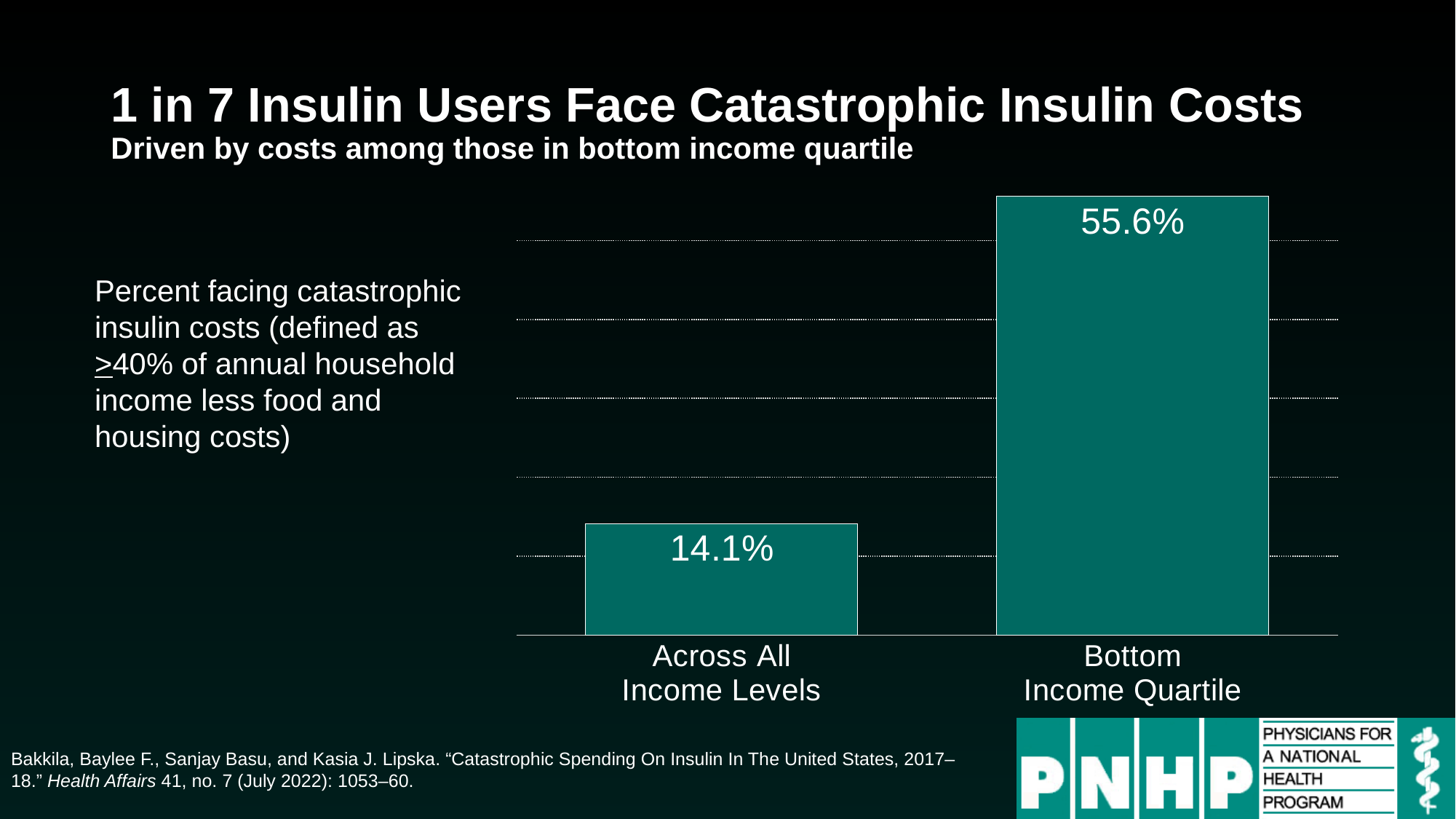
Is the value for the bottom income quartile larger or smaller than the value across all income levels? larger What percent of insulin users across all income levels face catastrophic insulin costs? 14.1% What is the difference in percentage points between the bottom income quartile and across all income levels? 41.5 Which category has the lower percentage facing catastrophic insulin costs? Across All Income Levels What colour are the bars in the chart? teal What kind of chart is shown on the slide? bar chart Which category has the higher percentage facing catastrophic insulin costs? Bottom Income Quartile What is the title of the slide? 1 in 7 Insulin Users Face Catastrophic Insulin Costs What percent of insulin users in the bottom income quartile face catastrophic insulin costs? 55.6% How many categories are shown in the chart? 2